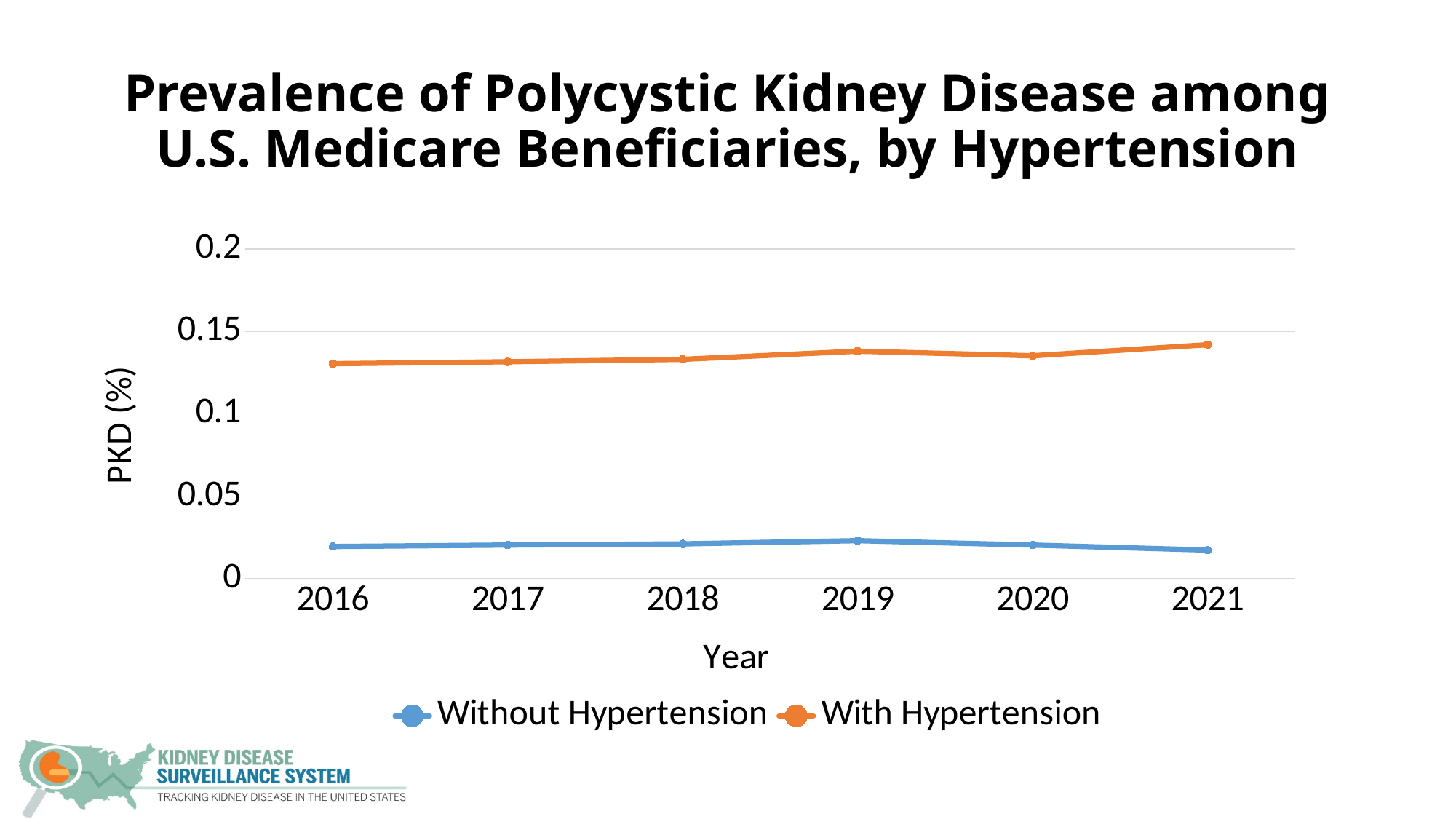
Is the value for With Hypertension in 2021 greater or less than 0.15? less In which year is the With Hypertension series at its highest? 2021 In which year is the Without Hypertension series at its lowest? 2021 What is the label on the y axis? PKD (%) Does the With Hypertension series rise or fall overall from 2016 to 2021? rise In which year is the Without Hypertension series at its highest? 2019 Is the value for With Hypertension in 2016 greater or less than 0.1? greater How many years are plotted along the x axis? 6 How many series does the legend list? 2 Is the value for Without Hypertension in 2019 greater or less than 0.05? less Which series has the higher value in 2018, With Hypertension or Without Hypertension? With Hypertension What kind of chart is shown on the slide? line chart